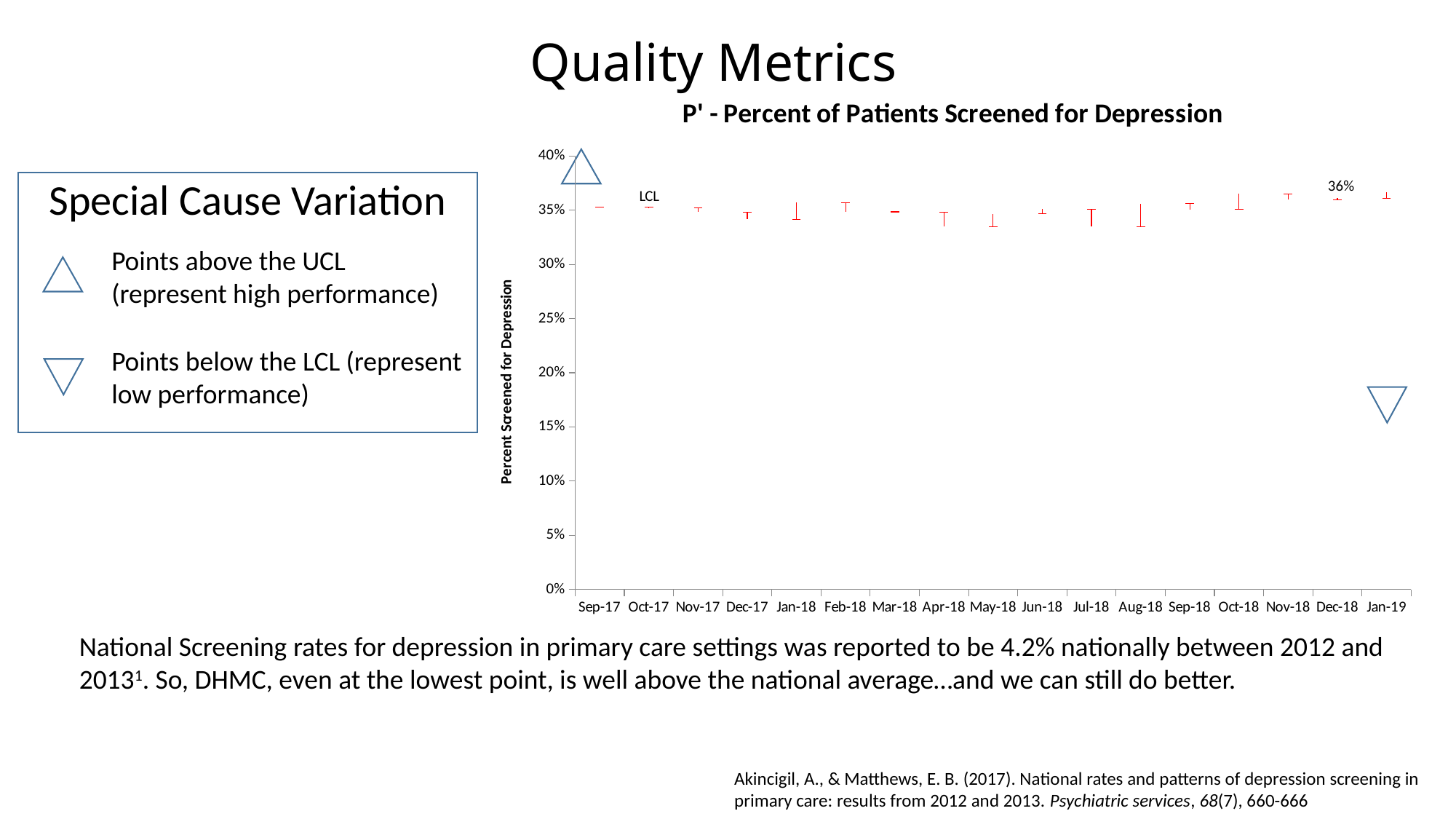
What value is labelled on the chart for Dec-18? 36% What is the first month shown on the x axis? Sep-17 What is the highest value shown on the vertical axis? 40% How many months are shown on the x axis of the chart? 17 What is the label on the vertical axis of the chart? Percent Screened for Depression What is the title of the chart? P' - Percent of Patients Screened for Depression Is the value for Dec-18 greater or less than 30%? greater What kind of chart is shown on the slide? control chart What is the last month shown on the x axis? Jan-19 Is the value for Jan-19 greater or less than 40%? less Is the value for May-18 greater or less than 30%? greater